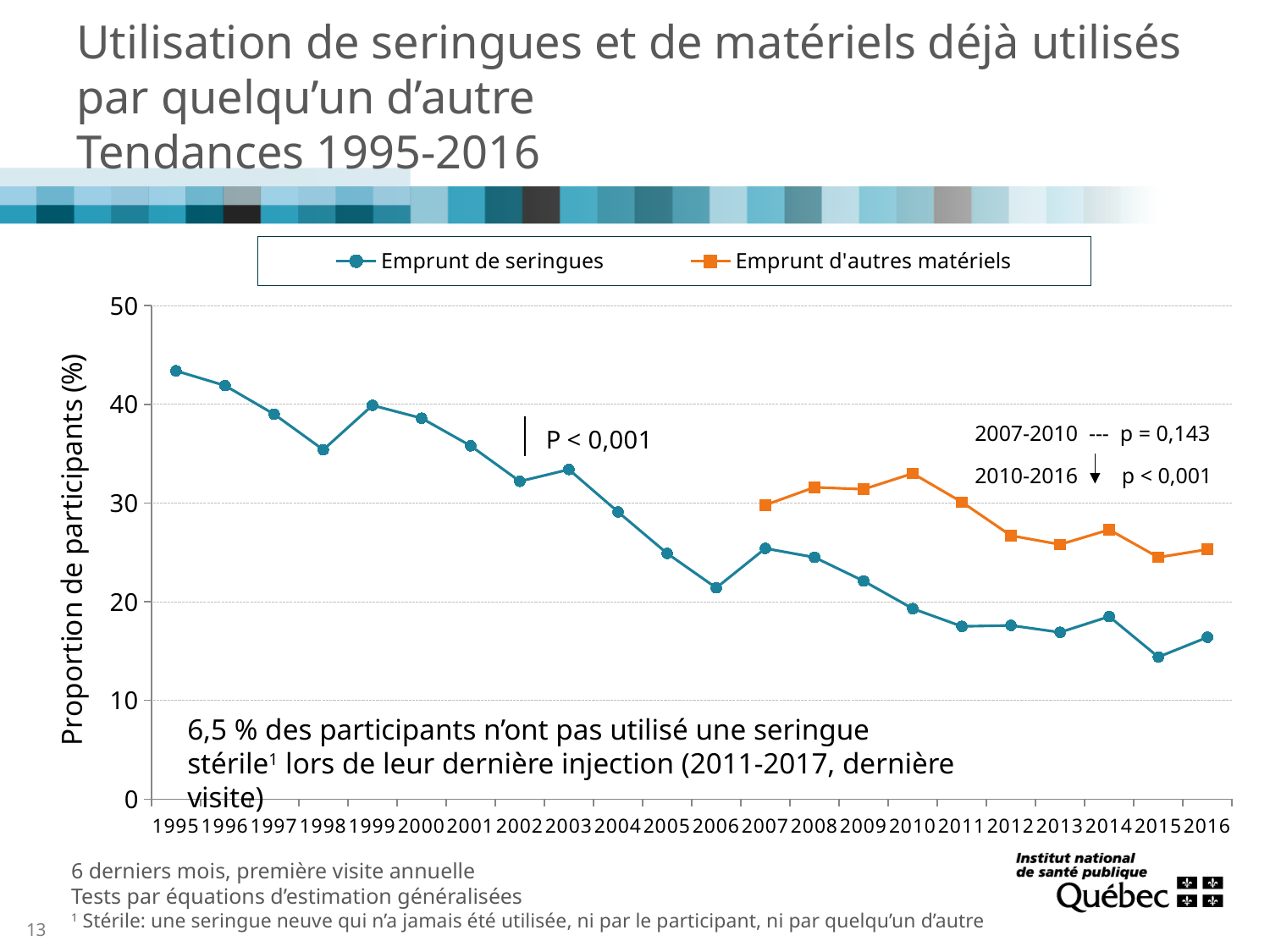
In which year is the value for Emprunt de seringues lowest? 2015 In which year is the value for Emprunt d'autres matériels highest? 2010 In which year is the value for Emprunt de seringues highest? 1995 Is the value for Emprunt de seringues in 1995 greater or less than 40? greater In 2010, which series has the larger value, Emprunt de seringues or Emprunt d'autres matériels? Emprunt d'autres matériels What is the label of the y axis? Proportion de participants (%) Is the value for Emprunt de seringues in 2015 greater or less than 20? less How many years are shown on the x axis? 22 Is the value for Emprunt d'autres matériels in 2010 greater or less than 30? greater How many series does the legend list? 2 What kind of chart is shown on the slide? line chart Overall, does the Emprunt de seringues series rise or fall from 1995 to 2016? fall